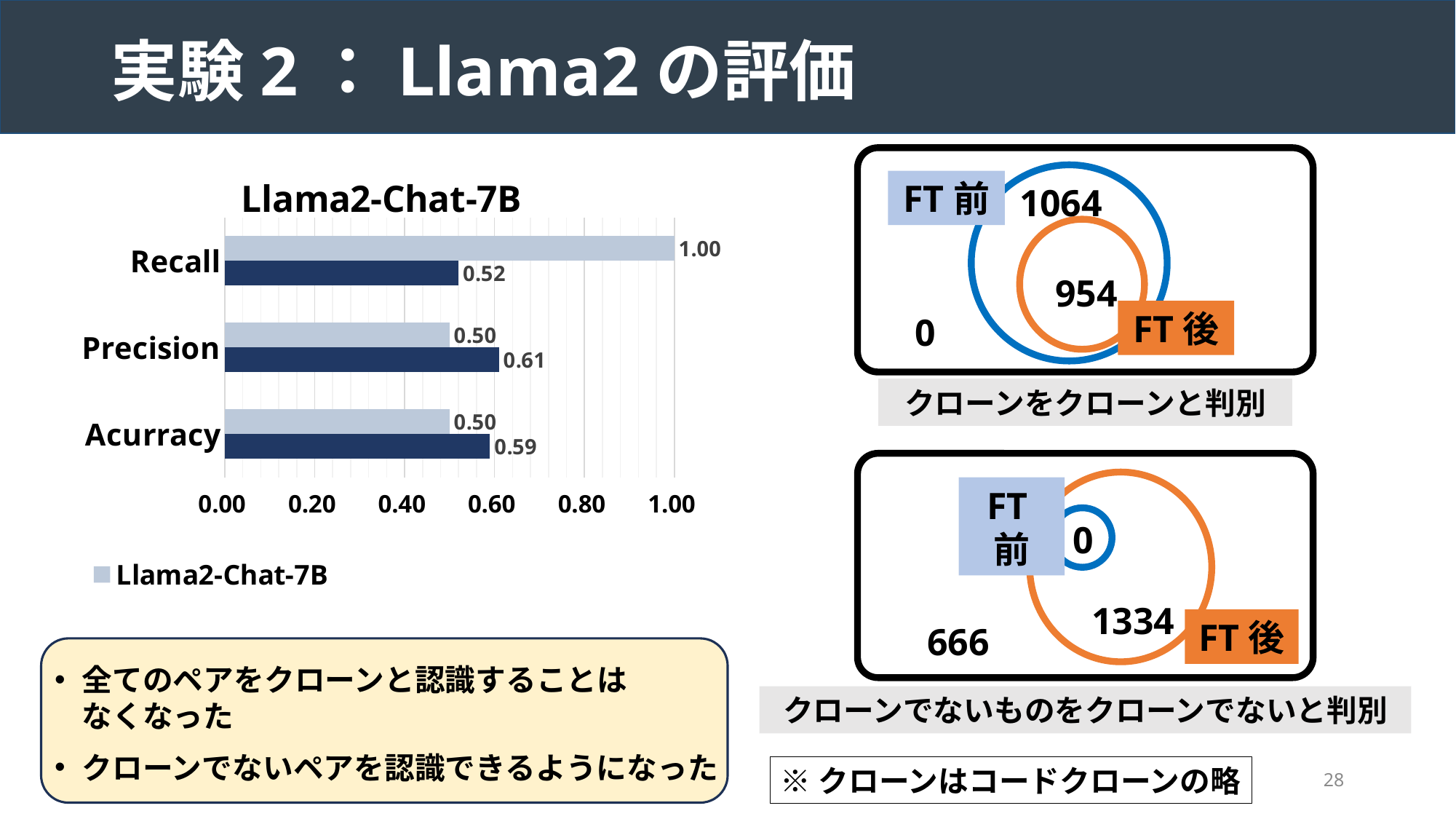
How many series does the chart's legend list? 1 What is the value of the light blue bar for Acurracy? 0.50 What is the value of the light blue bar for Recall? 1.00 What is the difference between the light blue bar and the dark navy bar for Recall? 0.48 What is the title of the chart? Llama2-Chat-7B What is the value of the dark navy bar for Precision? 0.61 Which category has the lowest value among the dark navy bars? Recall How many categories are shown on the chart's vertical axis? 3 For Precision, which bar is larger, the light blue bar or the dark navy bar? the dark navy bar What type of chart is shown on the slide? bar chart What is the value of the dark navy bar for Recall? 0.52 Which category has the highest value among the light blue bars? Recall